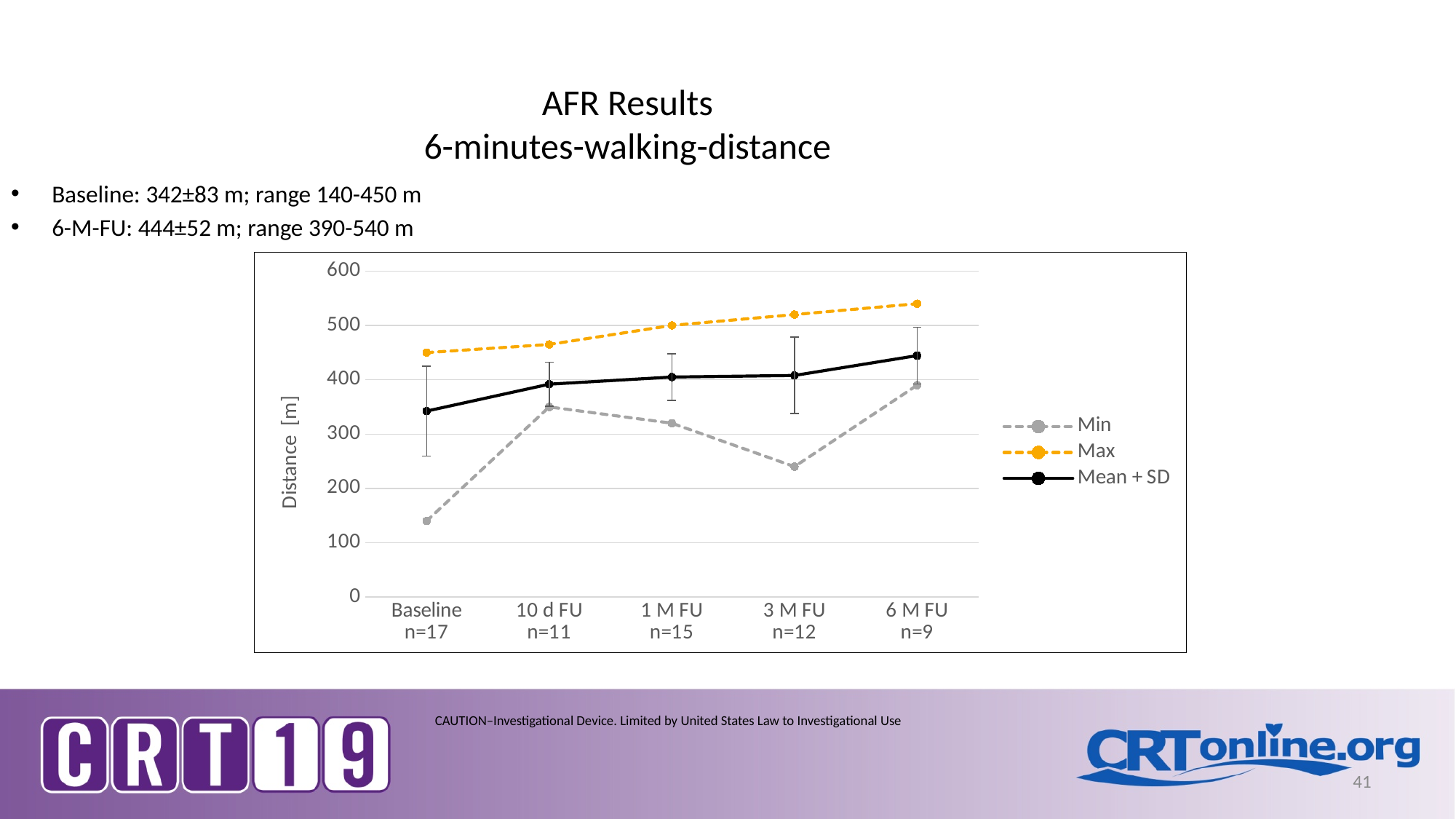
What is the mean 6-minute walking distance at 6-M-FU, as stated on the slide? 444 m By how many metres does the mean walking distance at 6-M-FU exceed the Baseline mean, using the values stated on the slide? 102 m Is the Min value at 3 M FU greater or less than 300? less How many time points are plotted along the x axis of the chart? 5 At which time point is the Min series lowest? Baseline n=17 What is the mean 6-minute walking distance at Baseline, as stated on the slide? 342 m Is the Max value at 6 M FU greater or less than 500? greater Is the Min value at Baseline greater or less than 200? less How many series does the chart legend list? 3 What kind of chart is shown on the slide? line chart At which time point is the Max series highest? 6 M FU n=9 Does the Max series rise or fall from Baseline to 6 M FU? rise